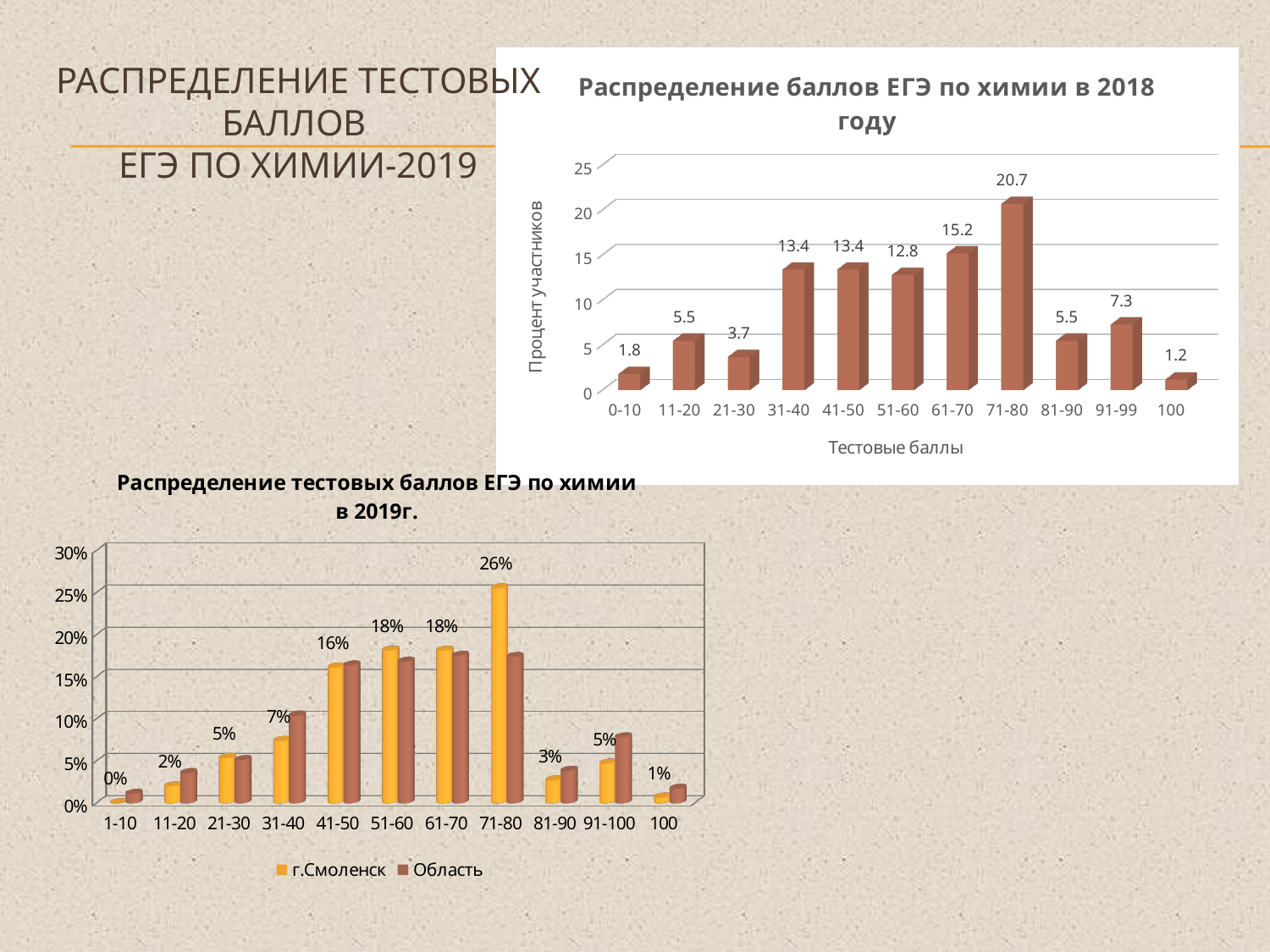
What kind of chart is the one titled "Распределение тестовых баллов ЕГЭ по химии в 2019г."? Bar chart In the chart titled "Распределение тестовых баллов ЕГЭ по химии в 2019г.", what is the value for г.Смоленск in the 71-80 score range? 26% In the chart titled "Распределение тестовых баллов ЕГЭ по химии в 2019г.", how many series does the legend list? 2 In the chart titled "Распределение баллов ЕГЭ по химии в 2018 году", what is the difference between the values for 71-80 and 61-70? 5.5 In the chart titled "Распределение баллов ЕГЭ по химии в 2018 году", how many score ranges are shown on the x axis? 11 In the chart titled "Распределение баллов ЕГЭ по химии в 2018 году", what is the y-axis title? Процент участников In the chart titled "Распределение баллов ЕГЭ по химии в 2018 году", what is the value for the 0-10 score range? 1.8 In the chart titled "Распределение баллов ЕГЭ по химии в 2018 году", which score range has the lowest value? 100 In the chart titled "Распределение баллов ЕГЭ по химии в 2018 году", which score range has the highest value? 71-80 In the chart titled "Распределение баллов ЕГЭ по химии в 2018 году", what is the value for the 71-80 score range? 20.7 In the chart titled "Распределение тестовых баллов ЕГЭ по химии в 2019г.", what is the value for г.Смоленск in the 31-40 score range? 7% In the chart titled "Распределение тестовых баллов ЕГЭ по химии в 2019г.", is the value for Область in the 71-80 score range greater or less than 15%? greater